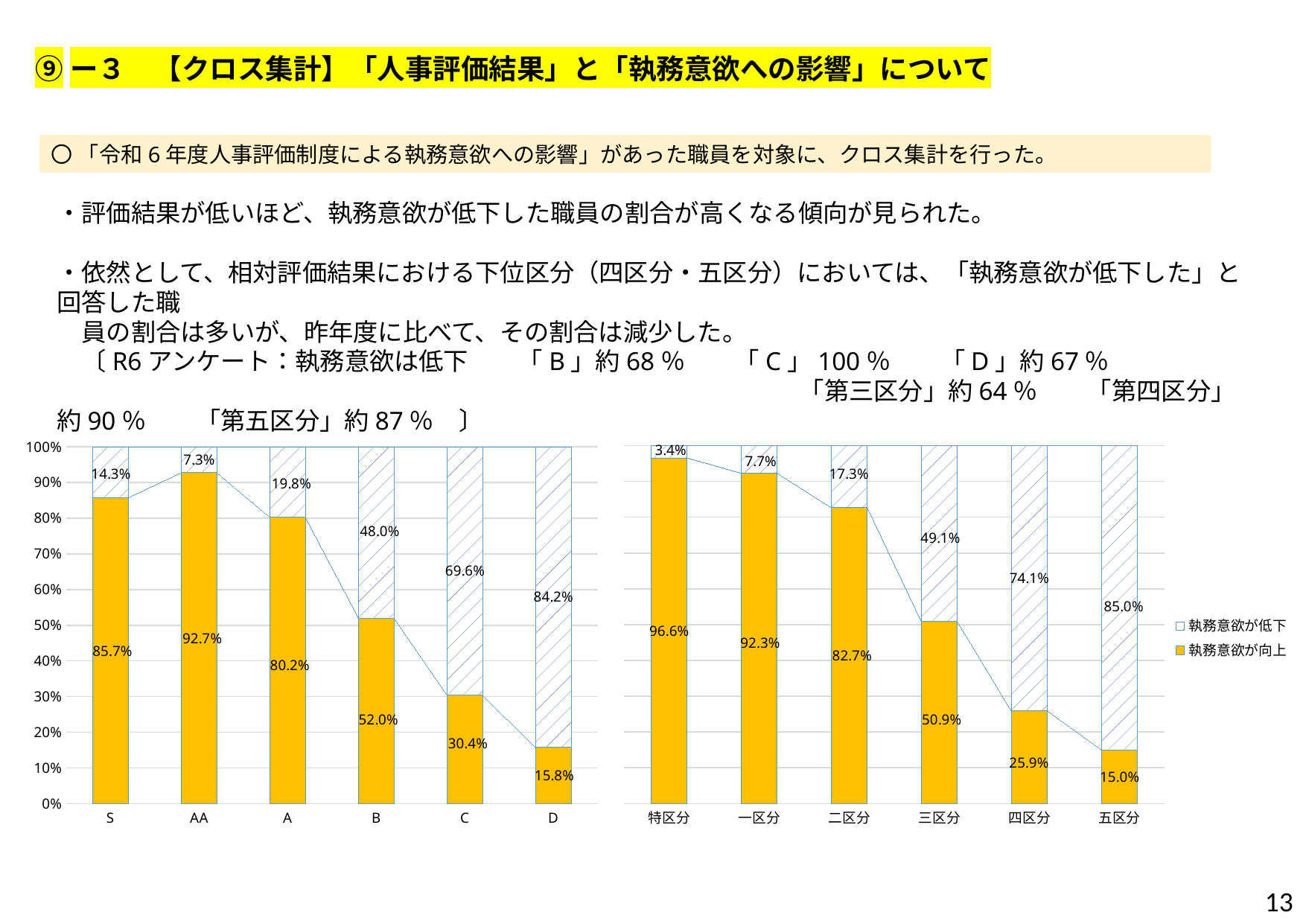
In the left chart, what is the 執務意欲が向上 value for category B? 52.0% In the right chart, which is larger: the 執務意欲が向上 value for 二区分 or for 三区分? 二区分 How many series does the legend list? 2 In the left chart, which category has the highest 執務意欲が向上 value? AA In the left chart, what is the 執務意欲が低下 value for category D? 84.2% How many categories are shown on the x axis of the right chart? 6 In the right chart, which category has the lowest 執務意欲が向上 value? 五区分 In the left chart, what is the difference between the 執務意欲が低下 values for C and B? 21.6% What kind of chart is the left chart? Stacked bar chart In the right chart, what is the 執務意欲が低下 value for 三区分? 49.1% In the right chart, does the 執務意欲が向上 value rise or fall from 特区分 to 五区分? Fall In the right chart, what is the 執務意欲が向上 value for 四区分? 25.9%